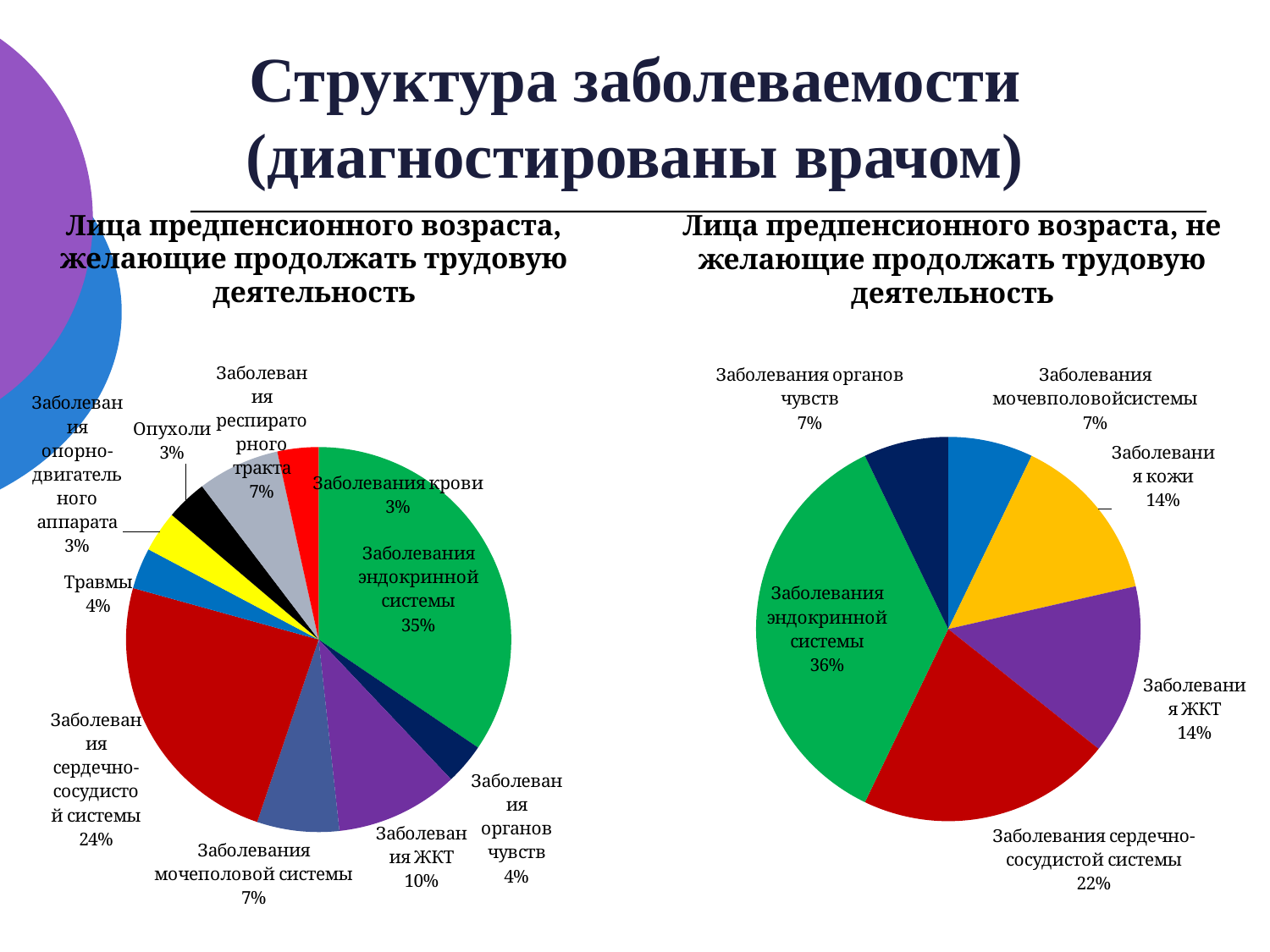
In the right pie chart (persons not wishing to continue working), what share is Заболевания эндокринной системы? 36% In the right pie chart (persons not wishing to continue working), what is the difference between the shares of Заболевания эндокринной системы and Заболевания сердечно-сосудистой системы? 14% In the left pie chart (persons wishing to continue working), how many slices does the pie have? 10 In the left pie chart (persons of pre-retirement age wishing to continue working), what share is Заболевания эндокринной системы? 35% In the right pie chart (persons not wishing to continue working), what share is Заболевания кожи? 14% In the right pie chart (persons not wishing to continue working), which is larger: Заболевания сердечно-сосудистой системы or Заболевания ЖКТ? Заболевания сердечно-сосудистой системы In the right pie chart (persons not wishing to continue working), how many slices does the pie have? 6 In the left pie chart (persons wishing to continue working), which category has the largest share? Заболевания эндокринной системы In the left pie chart (persons wishing to continue working), what share is Заболевания ЖКТ? 10% In the left pie chart (persons wishing to continue working), what share is Заболевания сердечно-сосудистой системы? 24% In the left pie chart (persons wishing to continue working), what is the difference between the shares of Заболевания эндокринной системы and Заболевания сердечно-сосудистой системы? 11% What type of chart is used on this slide? Pie chart